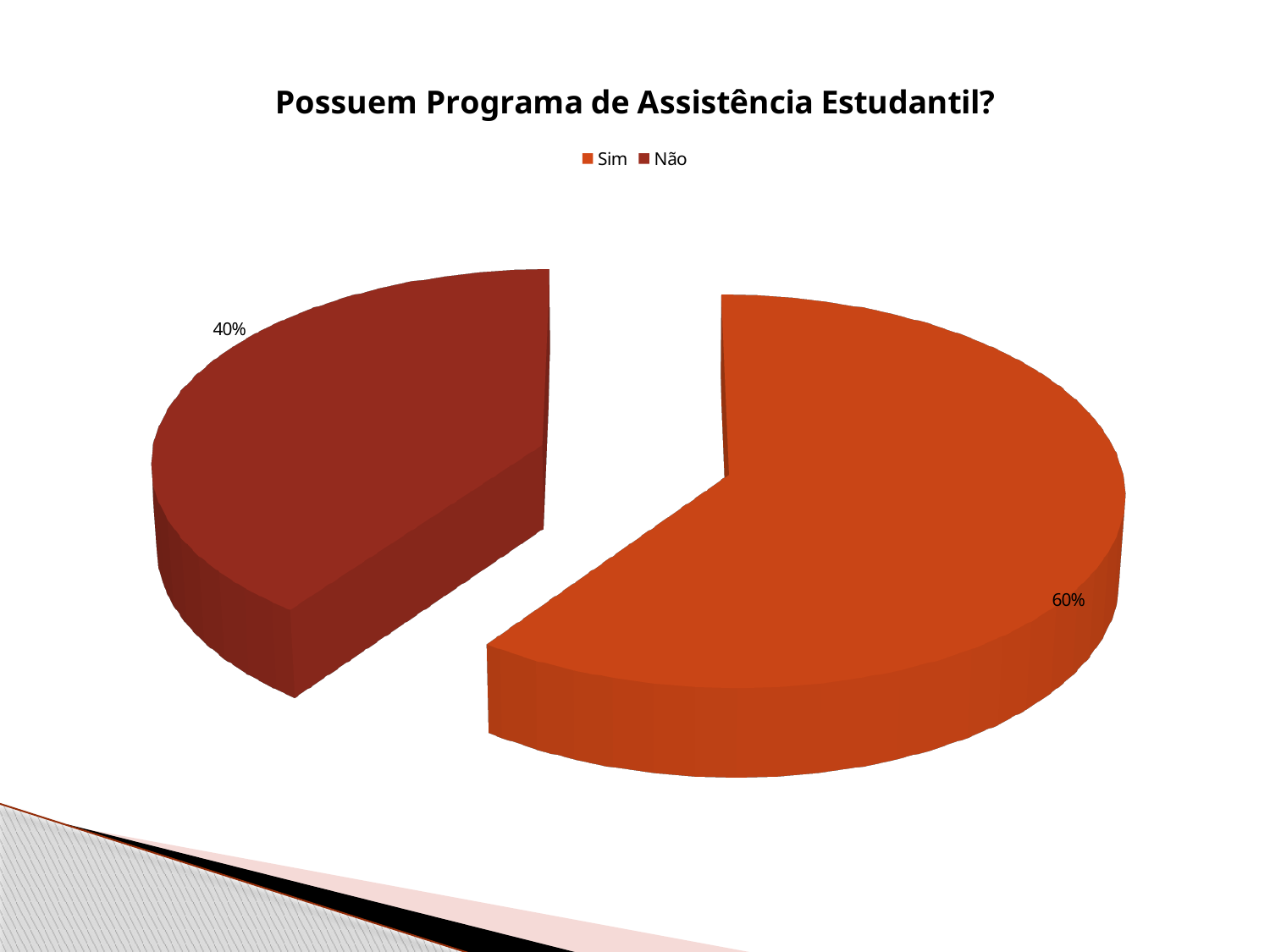
How many entries does the legend list? 2 What kind of chart is shown on the slide? pie chart Which is larger, the 'Sim' slice or the 'Não' slice? Sim What share of the pie does the 'Não' slice represent? 40% Which legend entry is shown in the darker red colour? Não How many slices does the pie chart have? 2 What is the difference in percentage points between the 'Sim' and 'Não' slices? 20% Which slice is the largest? Sim What is the title of the chart? Possuem Programa de Assistência Estudantil? What share of the pie does the 'Sim' slice represent? 60% Which slice is the smallest? Não